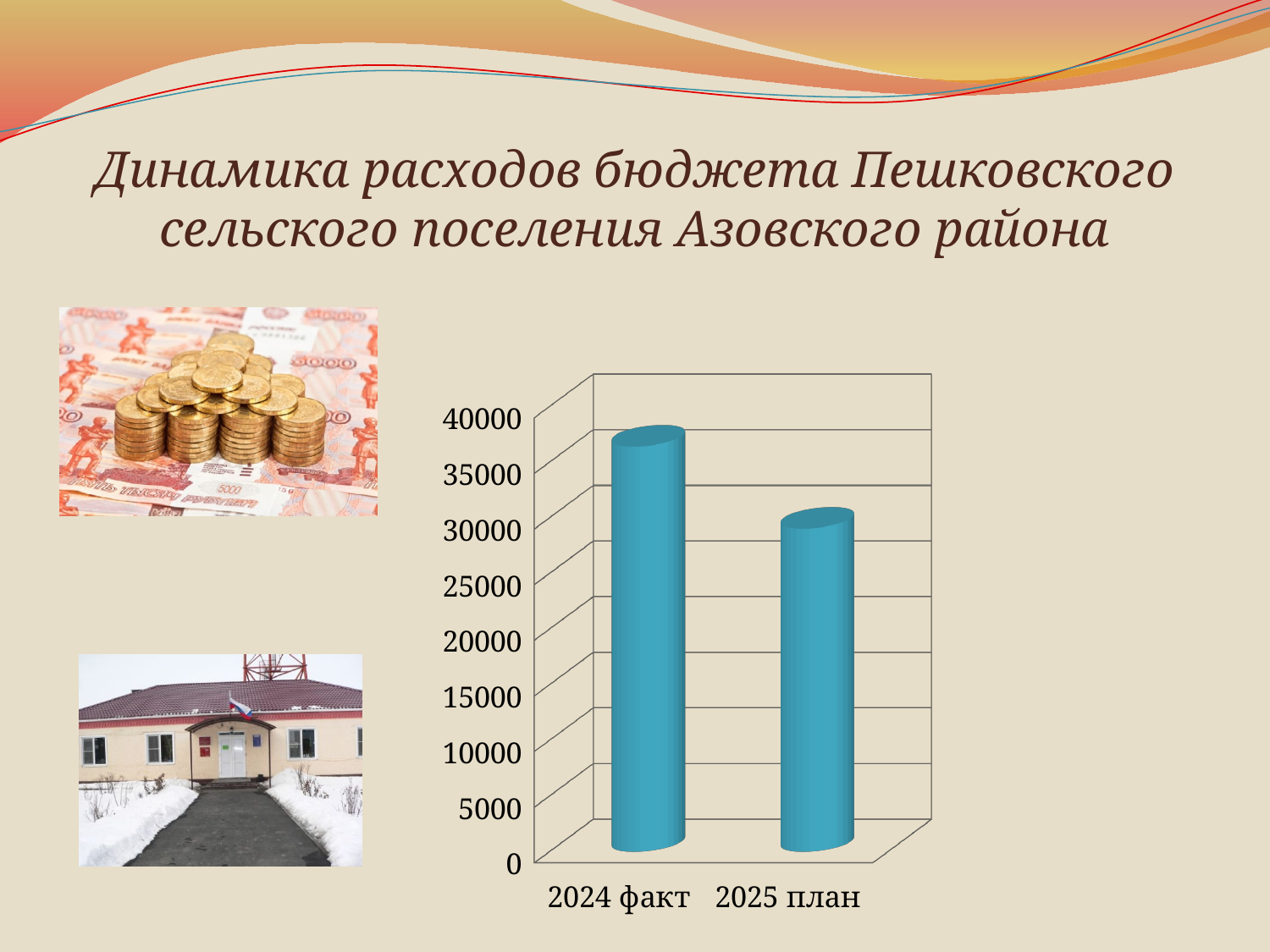
Which is larger, the value for 2024 факт or the value for 2025 план? 2024 факт Which category has the highest value in the chart? 2024 факт What is the highest tick value shown on the vertical axis of the chart? 40000 Is the value for 2025 план greater or less than 35000? less What is the title of the slide containing the chart? Динамика расходов бюджета Пешковского сельского поселения Азовского района How many categories are shown on the x axis of the chart? 2 Is the value for 2024 факт greater or less than 40000? less Is the value for 2024 факт greater or less than 35000? greater What kind of chart is shown on the slide? bar chart Do the values rise or fall from 2024 факт to 2025 план? fall Which category has the lowest value in the chart? 2025 план